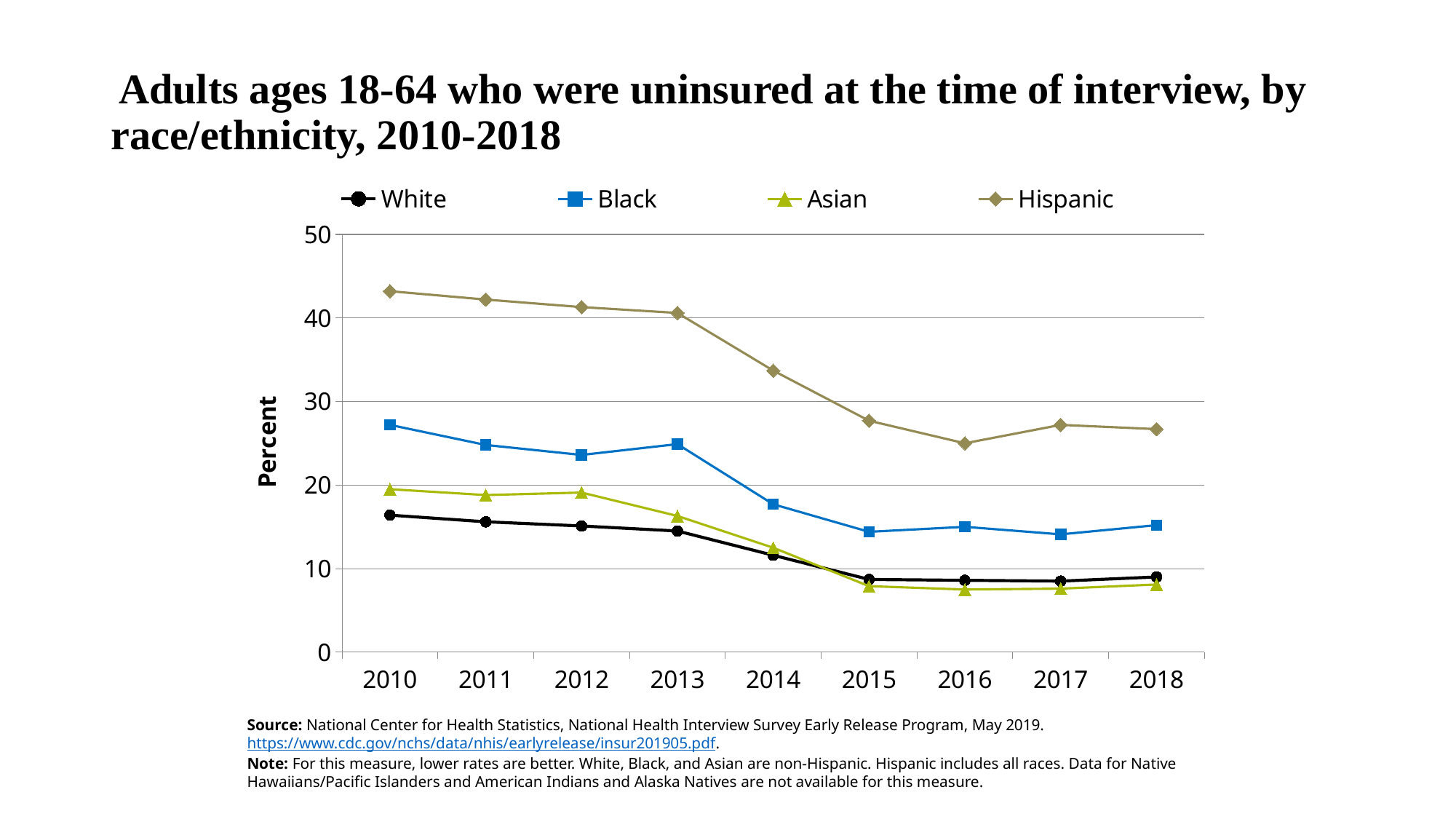
Which race/ethnicity group had the highest uninsured rate in 2010? Hispanic Which race/ethnicity group had the lowest uninsured rate in 2010? White What is the label on the y axis? Percent Is the value for Asian in 2016 greater or less than 10? less How many years are plotted along the x axis? 9 How many series does the legend list? 4 Did the uninsured rate for Hispanic adults rise or fall from 2010 to 2015? fall In 2013, which was larger, the value for Black or the value for Asian? Black Is the value for Black in 2014 greater or less than 20? less What kind of chart is shown on the slide? line chart Is the value for Hispanic in 2010 greater or less than 40? greater